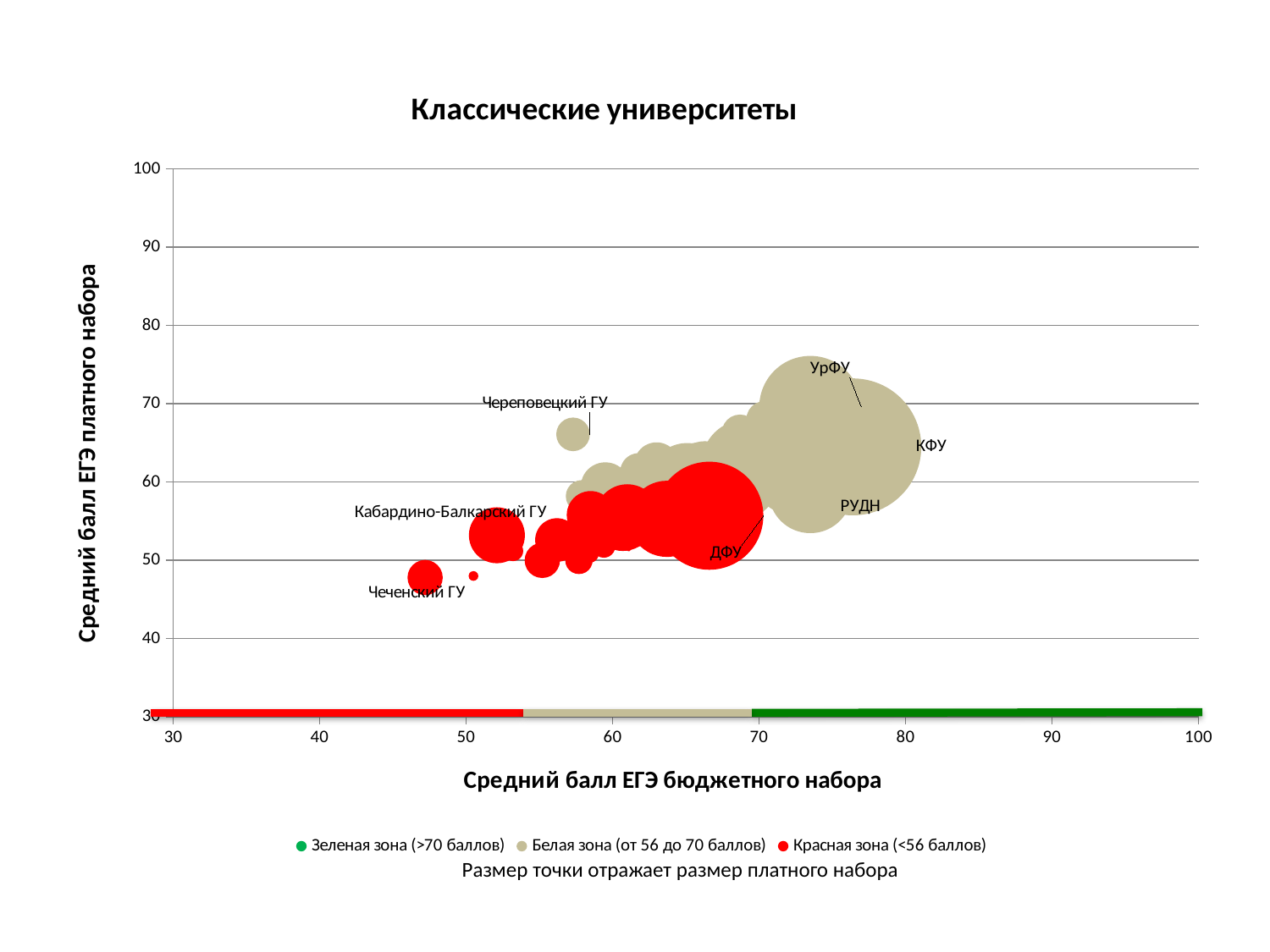
Is the value on the horizontal axis (Средний балл ЕГЭ бюджетного набора) for Чеченский ГУ greater or less than 50? less What kind of chart is shown on the slide? bubble chart Which has the higher value on the horizontal axis (Средний балл ЕГЭ бюджетного набора), КФУ or Кабардино-Балкарский ГУ? КФУ Is the value on the horizontal axis (Средний балл ЕГЭ бюджетного набора) for КФУ greater or less than 70? greater Which legend zone does the bubble for Чеченский ГУ belong to? Красная зона (<56 баллов) What is the title of the chart? Классические университеты Is the value on the horizontal axis (Средний балл ЕГЭ бюджетного набора) for РУДН greater or less than 70? greater Which labelled university has the largest bubble on the chart? КФУ How many series does the legend list? 3 Which has the higher value on the vertical axis (Средний балл ЕГЭ платного набора), Череповецкий ГУ or Чеченский ГУ? Череповецкий ГУ